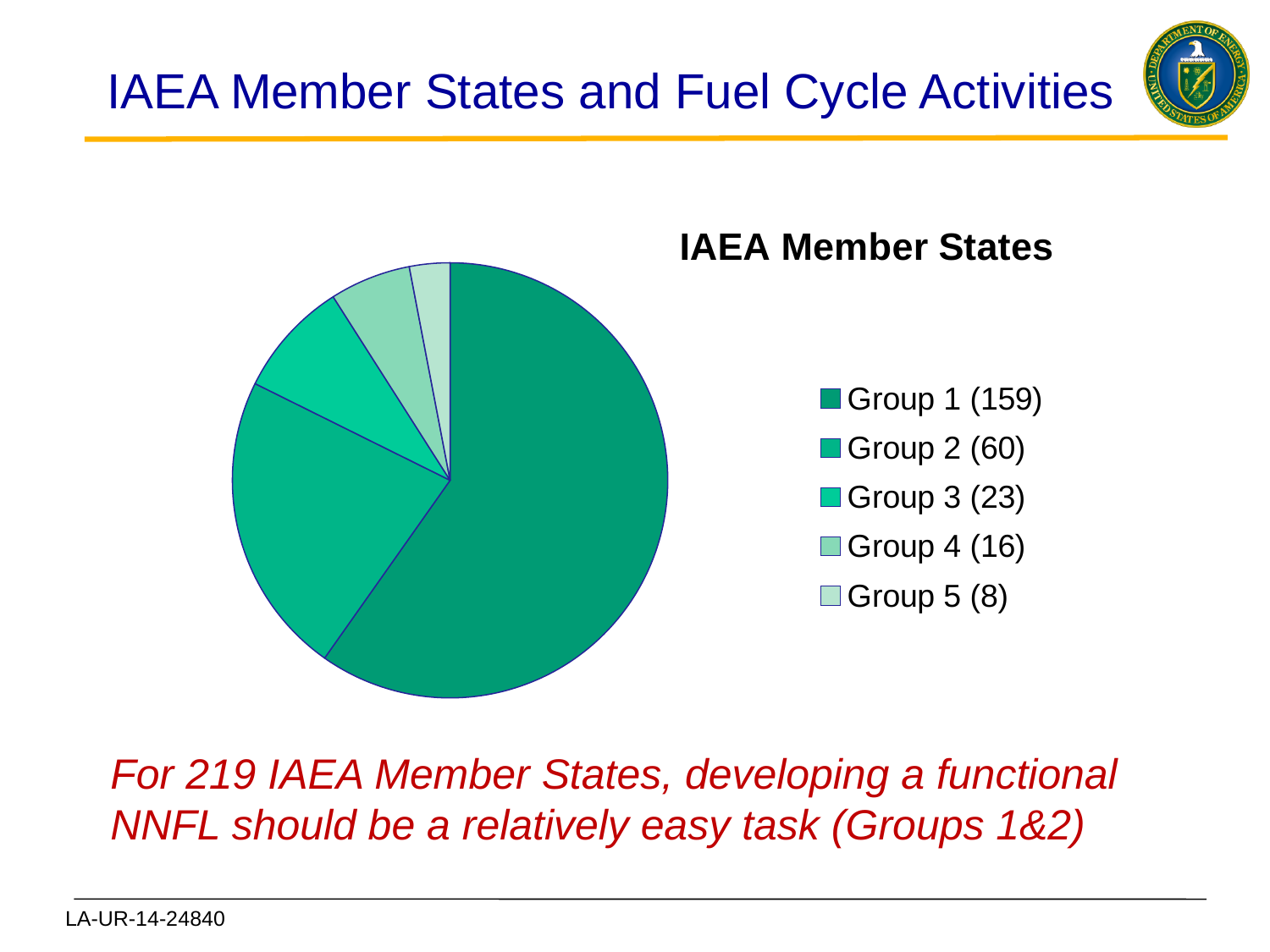
Which is larger, the value for Group 3 or the value for Group 4? Group 3 Which group has the largest slice of the pie? Group 1 What is the value for Group 2? 60 What is the title of the chart? IAEA Member States What is the value for Group 3? 23 What is the value for Group 4? 16 How many groups (slices) does the pie chart show? 5 What is the value for Group 5? 8 What type of chart is shown on the slide? Pie chart What is the value for Group 1? 159 Which group has the smallest slice of the pie? Group 5 What is the difference between the values for Group 1 and Group 2? 99